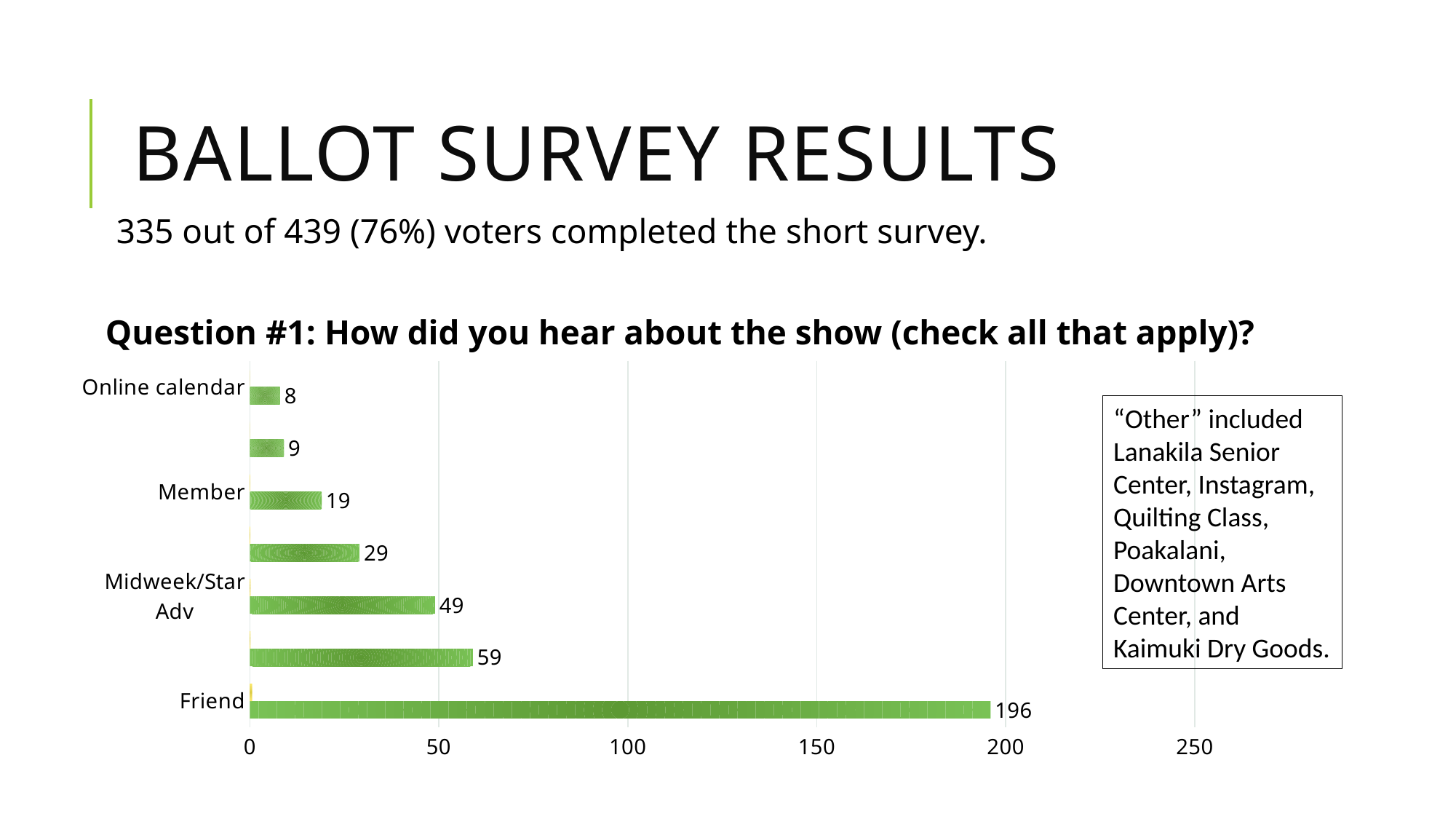
Is the value for Friend greater or less than 150? greater Which is larger, the value for Member or the value for Online calendar? Member What kind of chart is shown on the slide? Bar chart What is the value for Member? 19 What is the difference between the values for Midweek/Star Adv and Online calendar? 41 What is the value for Friend? 196 Which category has the highest value? Friend What is the value for Midweek/Star Adv? 49 What is the difference between the values for Friend and Member? 177 How many bars are plotted in the chart? 7 What is the value for Online calendar? 8 Which category has the lowest value? Online calendar